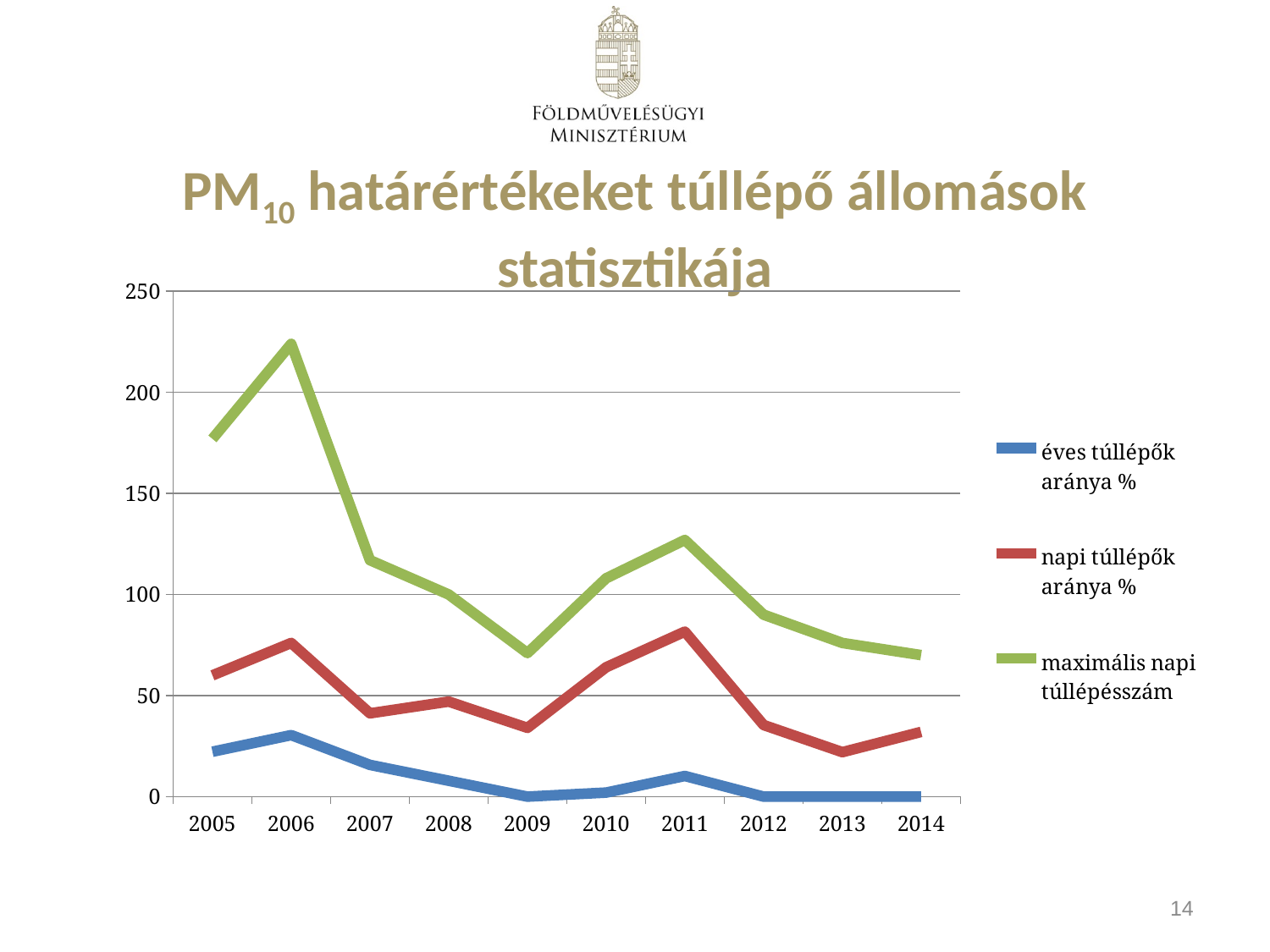
How many years are shown on the x axis? 10 In which year is the value for 'éves túllépők aránya %' highest? 2006 Is the value for 'napi túllépők aránya %' in 2011 greater or less than 50? greater Which is larger for 'maximális napi túllépésszám': the value in 2005 or the value in 2007? 2005 Is the value for 'maximális napi túllépésszám' in 2009 greater or less than 100? less In which year is the value for 'maximális napi túllépésszám' highest? 2006 What kind of chart is shown on the slide? line chart Is the value for 'maximális napi túllépésszám' in 2006 greater or less than 200? greater Do the values for 'maximális napi túllépésszám' rise or fall from 2011 to 2014? fall Which colour represents 'napi túllépők aránya %' in the legend? red How many series does the legend list? 3